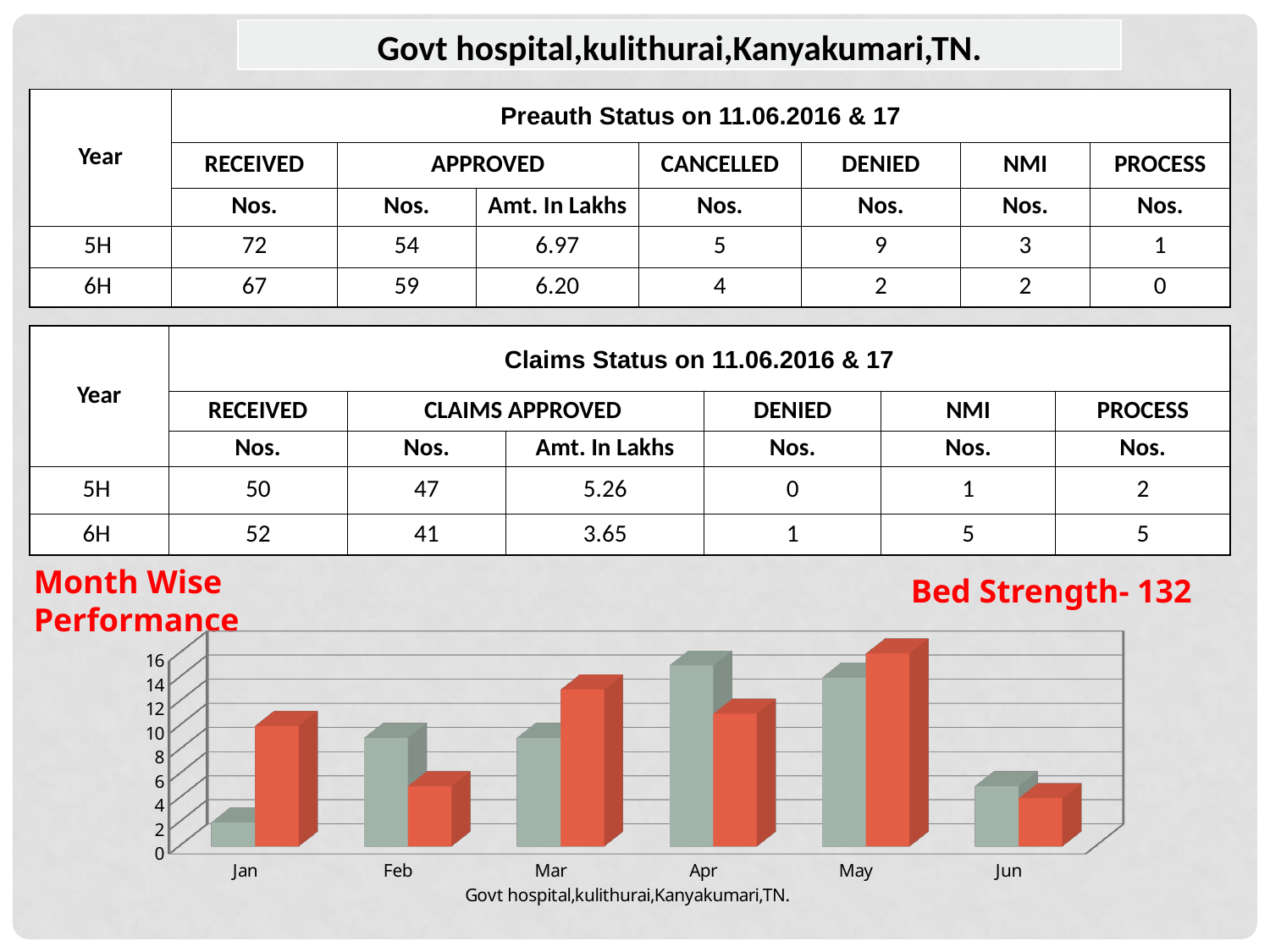
In the Month Wise Performance chart, which month has the highest red bar? May In the Month Wise Performance chart, which month has the lowest grey bar? Jan How many months are shown on the x axis of the Month Wise Performance chart? 6 What kind of chart is shown under the 'Month Wise Performance' heading? bar chart In the Month Wise Performance chart, is the red bar for May greater or less than 14? greater In the Month Wise Performance chart, is the grey bar for Apr greater or less than 12? greater In the Month Wise Performance chart, is the red bar for Jan greater or less than 8? greater What text appears below the x axis of the Month Wise Performance chart? Govt hospital,kulithurai,Kanyakumari,TN. In the Month Wise Performance chart, which is larger for Mar, the grey bar or the red bar? the red bar In the Month Wise Performance chart, which is larger for Feb, the grey bar or the red bar? the grey bar